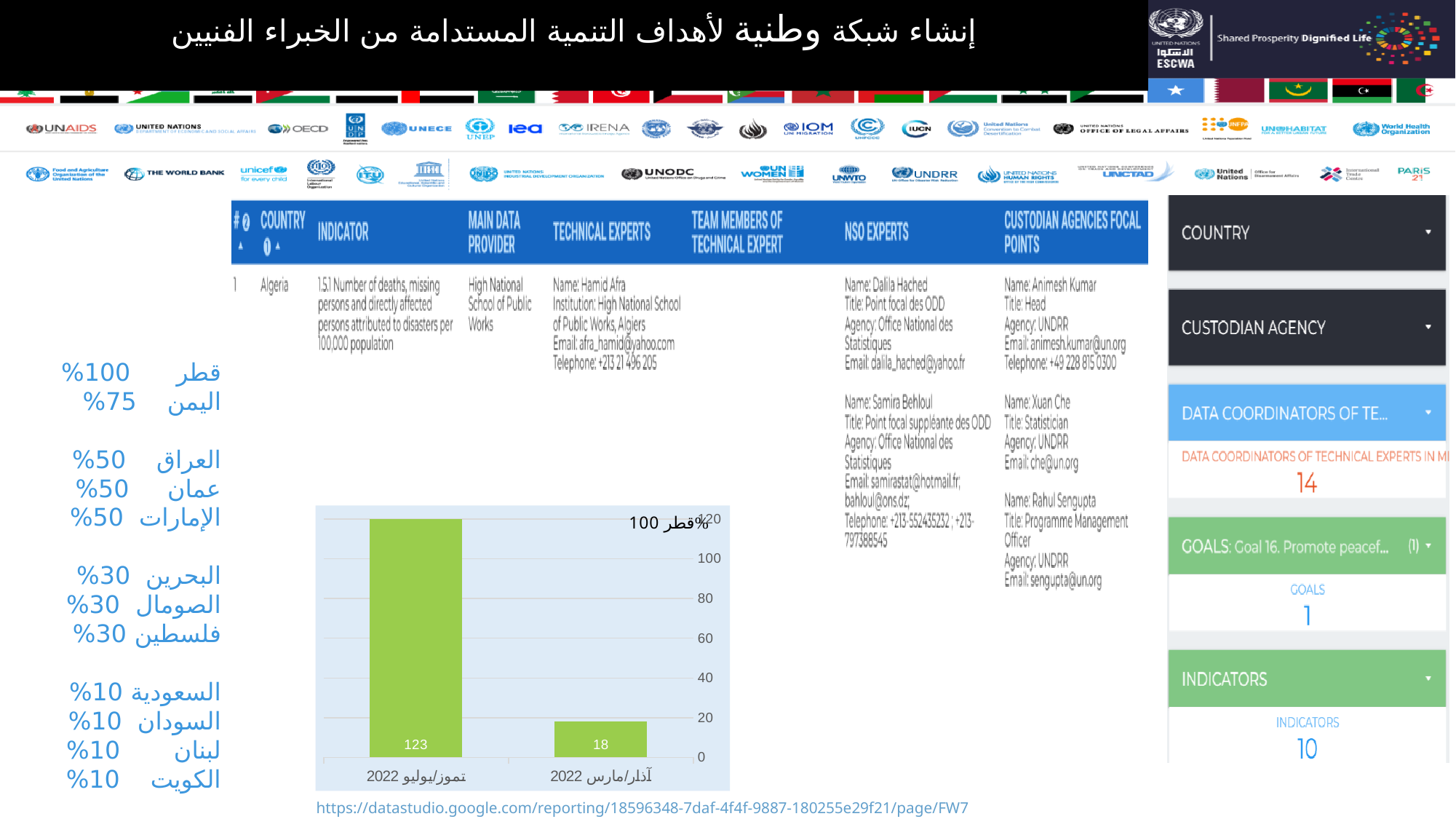
Is the value for آذار/مارس 2022 in the bar chart greater or less than 40? less Which category has the highest value in the bar chart? تموز/يوليو 2022 Is the value for تموز/يوليو 2022 in the bar chart greater or less than 100? greater Do the bar values rise or fall from left to right along the x axis of the bar chart? fall Which category has the lowest value in the bar chart? آذار/مارس 2022 What kind of chart is shown at the bottom of the slide? bar chart What is the difference between the values for تموز/يوليو 2022 and آذار/مارس 2022 in the bar chart? 105 What is the value of the bar for تموز/يوليو 2022 (July 2022) in the bar chart? 123 What colour are the bars in the bar chart? green Which is larger in the bar chart: the value for تموز/يوليو 2022 or the value for آذار/مارس 2022? تموز/يوليو 2022 How many categories are shown on the x axis of the bar chart? 2 What is the value of the bar for آذار/مارس 2022 (March 2022) in the bar chart? 18